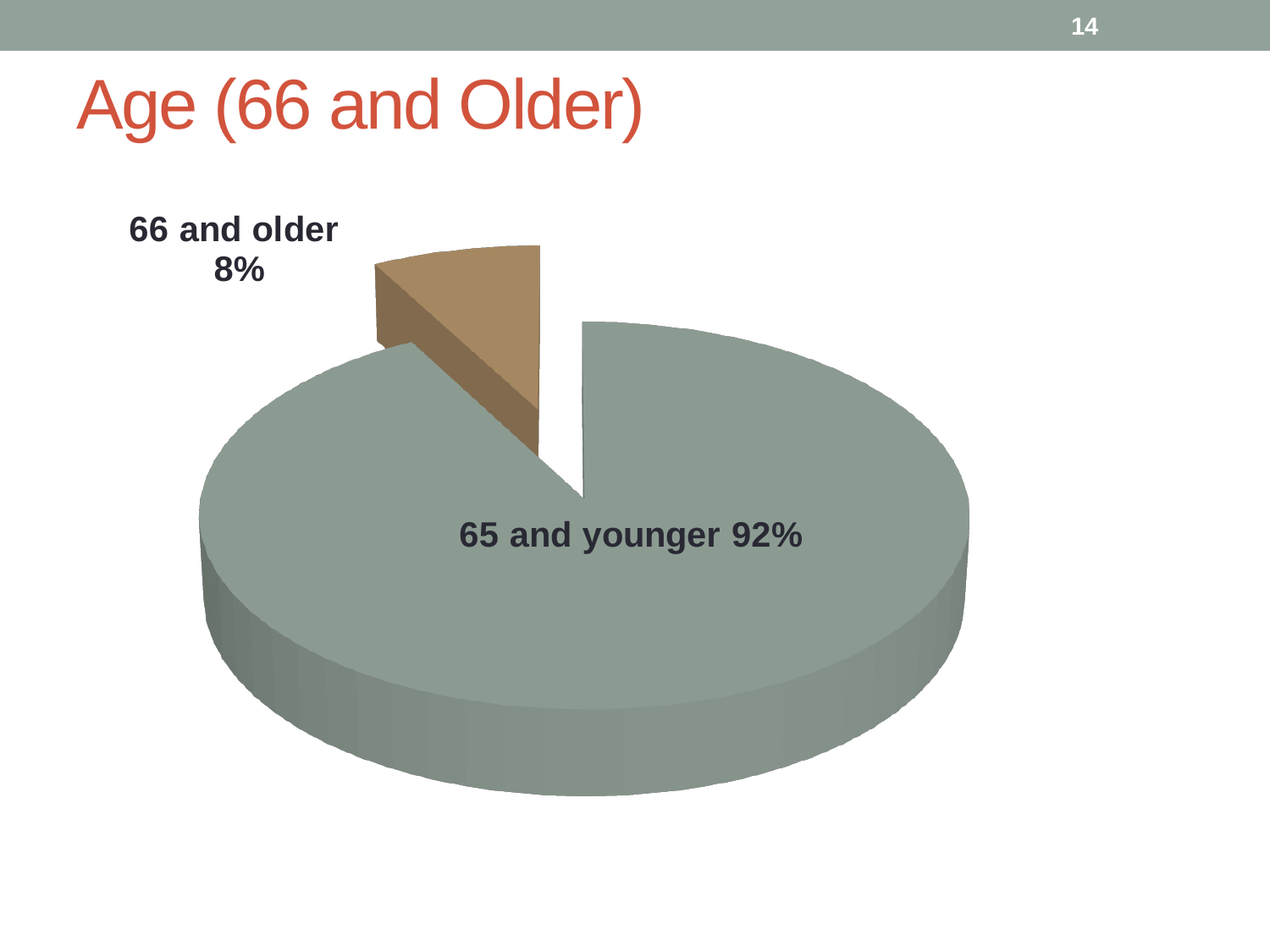
What share of the pie is labelled "65 and younger"? 92% What share of the pie is labelled "66 and older"? 8% How many slices does the pie chart have? 2 Which is larger, the "66 and older" slice or the "65 and younger" slice? 65 and younger Which slice of the pie is the smallest? 66 and older What is the difference in percentage points between the "65 and younger" slice and the "66 and older" slice? 84 Which slice of the pie is the largest? 65 and younger What is the title of the slide containing the pie chart? Age (66 and Older) Which slice is pulled out (exploded) from the rest of the pie? 66 and older What kind of chart is shown on the slide? pie chart